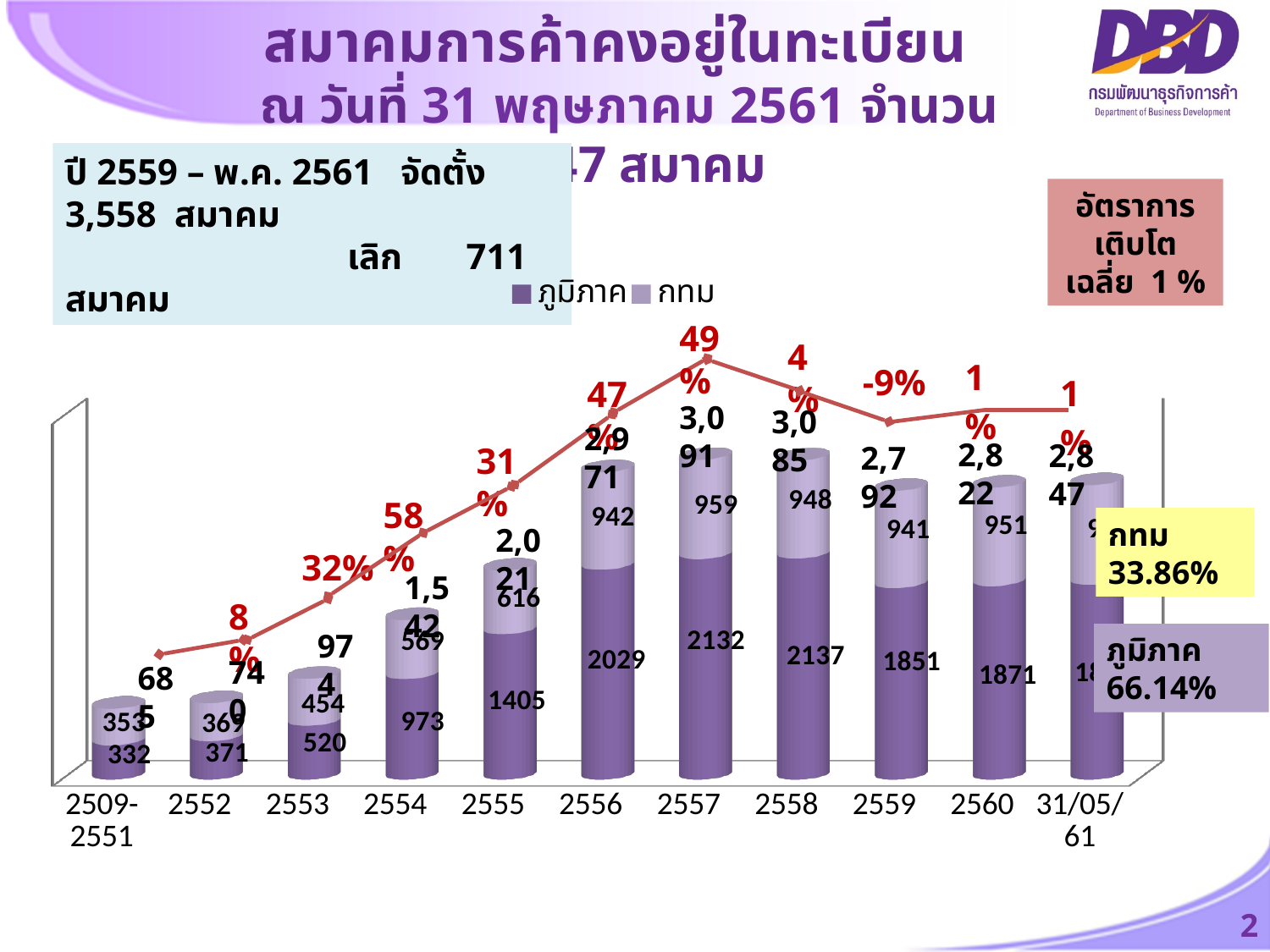
What growth rate is shown on the line for 2554? 58% In 2555, which is larger, ภูมิภาค or กทม? ภูมิภาค How many series does the legend list? 2 What is the value for ภูมิภาค in 2556? 2029 How many categories are shown on the x axis? 11 Do the ภูมิภาค values rise or fall from 2509-2551 to 2557? rise Which category has the lowest ภูมิภาค value? 2509-2551 What growth rate is shown on the line for 2559? -9% What is the value for กทม in 2557? 959 What is the value for ภูมิภาค in 2555? 1405 What is the difference between the ภูมิภาค and กทม values in 2556? 1087 What is the total of the stacked bar for 2557? 3,091